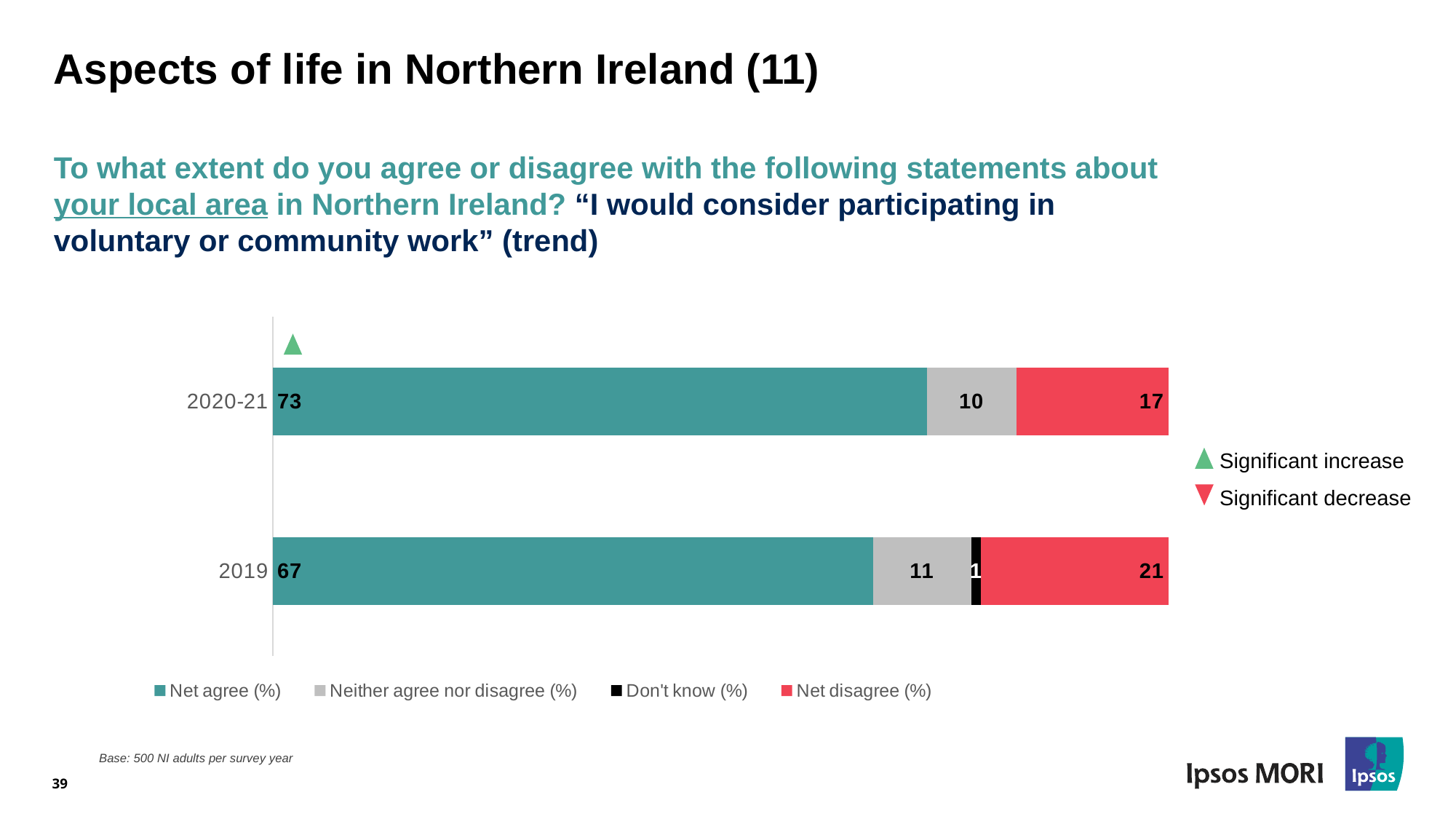
How many survey years are shown in the chart? 2 What kind of chart is shown on the slide? Stacked bar chart What is the difference between the Net agree (%) values for 2020-21 and 2019? 6 What is the difference between the Net disagree (%) values for 2019 and 2020-21? 4 What is the Net agree (%) value for 2020-21? 73 Which year has the lower Net disagree (%) value? 2020-21 How many series does the chart legend list? 4 Which year has the higher Net agree (%) value? 2020-21 What is the Neither agree nor disagree (%) value for 2020-21? 10 What is the Don't know (%) value for 2019? 1 Is the Neither agree nor disagree (%) value larger for 2019 or for 2020-21? 2019 What is the Net disagree (%) value for 2019? 21